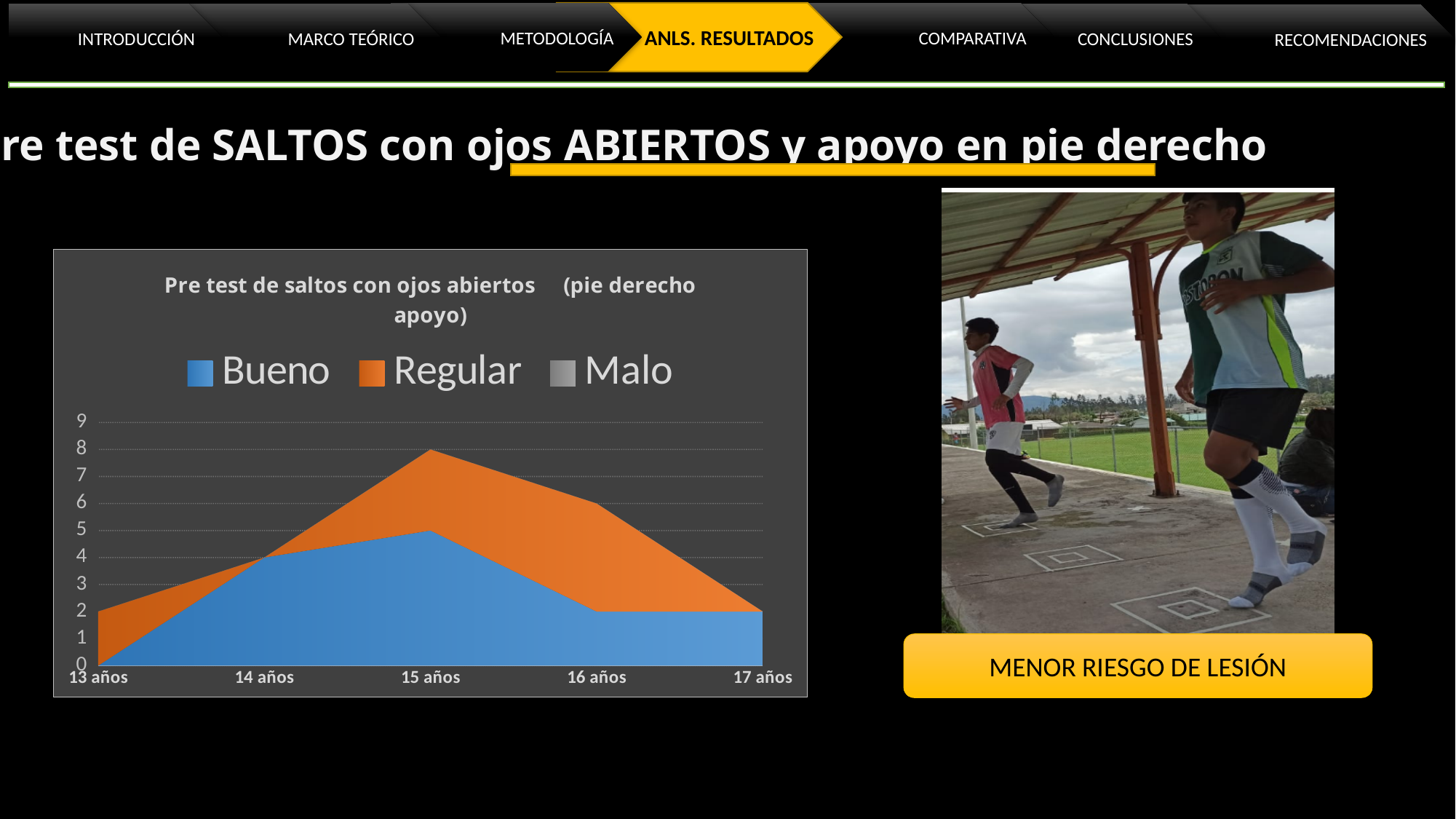
Which age category has the highest value for Bueno? 15 años Is the value for Bueno at 15 años greater or less than 3? greater How many age categories are shown on the x axis? 5 Which is larger for Bueno: the value at 14 años or at 16 años? 14 años Is the value for Bueno at 16 años greater or less than 3? less What kind of chart is shown on the slide? area chart Which series are listed in the legend? Bueno, Regular, Malo How many series does the legend list? 3 Does the Bueno series rise or fall from 15 años to 17 años? fall Is the value for Bueno at 13 años greater or less than 1? less Which age category has the lowest value for Bueno? 13 años